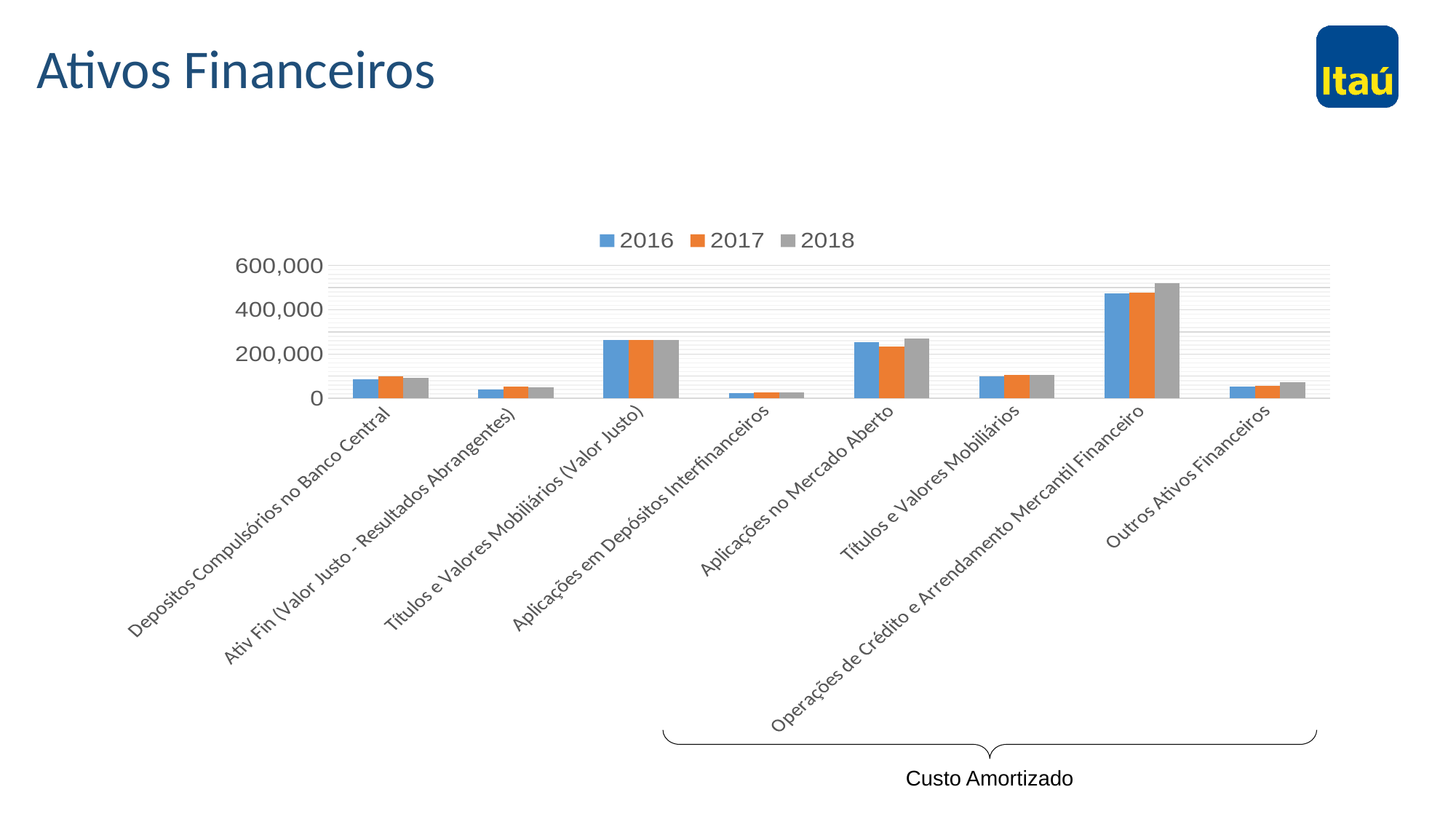
What label appears under the bracket grouping the last five categories? Custo Amortizado Which years are listed in the chart legend? 2016, 2017, 2018 Is the 2017 value for Títulos e Valores Mobiliários (Valor Justo) greater or less than 200,000? greater For 2018, which is larger: Operações de Crédito e Arrendamento Mercantil Financeiro or Títulos e Valores Mobiliários (Valor Justo)? Operações de Crédito e Arrendamento Mercantil Financeiro Is the 2017 value for Depósitos Compulsórios no Banco Central greater or less than 200,000? less For 2016, which is larger: Depósitos Compulsórios no Banco Central or Ativ Fin (Valor Justo - Resultados Abrangentes)? Depósitos Compulsórios no Banco Central What kind of chart is shown on the slide? bar chart How many categories are shown on the x axis? 8 How many series does the legend list? 3 Is the 2018 value for Operações de Crédito e Arrendamento Mercantil Financeiro greater or less than 400,000? greater Which category has the lowest value for 2016? Aplicações em Depósitos Interfinanceiros Which category has the highest value for 2018? Operações de Crédito e Arrendamento Mercantil Financeiro